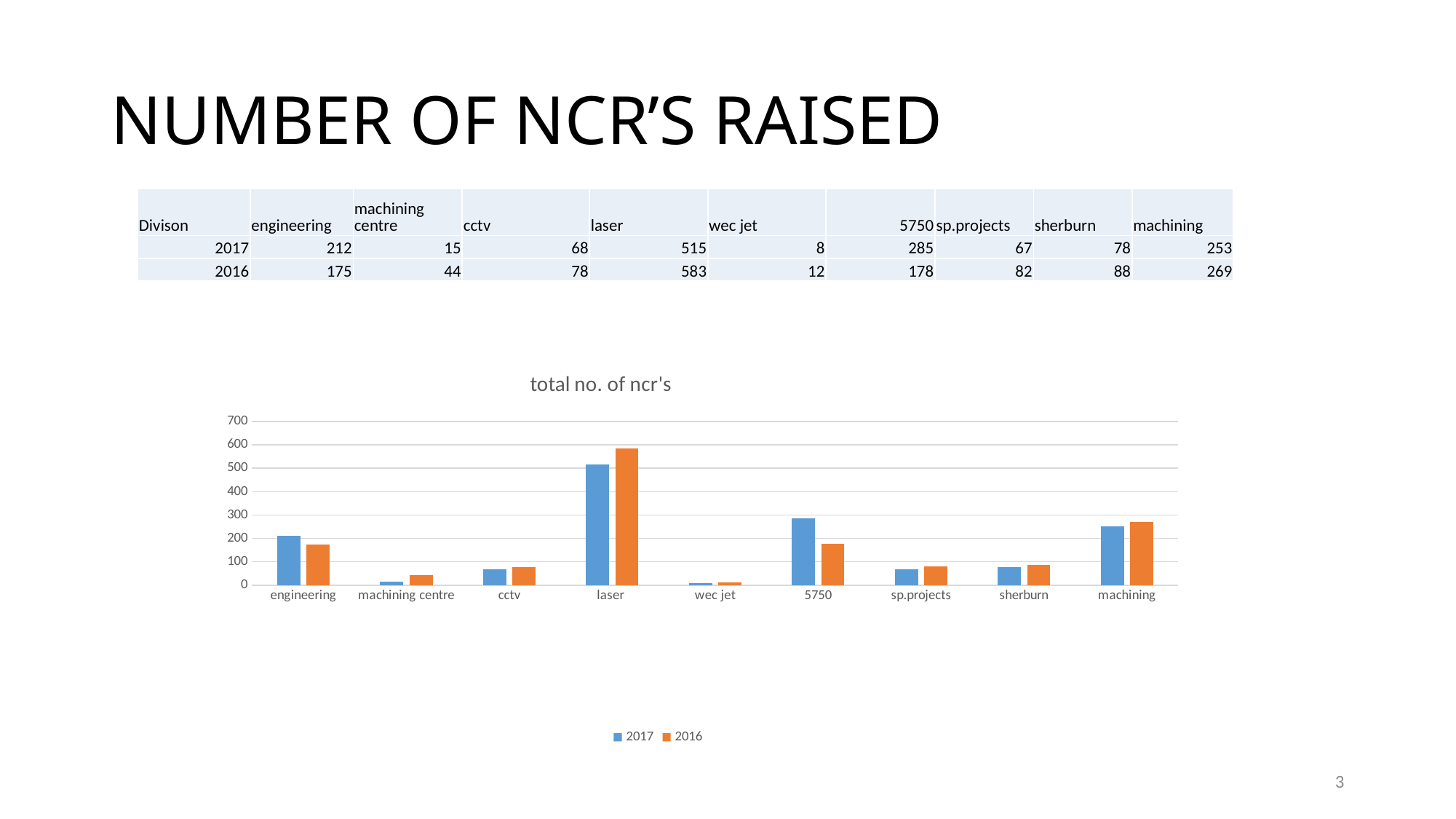
According to the table, how many NCRs were raised for laser in 2016? 583 Which division has the highest number of NCRs in 2017? laser How many series does the chart legend list? 2 What type of chart is shown on the slide? bar chart What is the difference between the 2017 and 2016 values for engineering? 37 Which division has the lowest number of NCRs in 2016? wec jet How many divisions are shown along the x axis of the chart? 9 What is the title of the chart? total no. of ncr's According to the table, how many NCRs were raised for 5750 in 2017? 285 Is the 2016 value for laser greater or less than 500? greater For 5750, which year has the larger value, 2017 or 2016? 2017 Which colour represents the 2016 series in the chart? orange